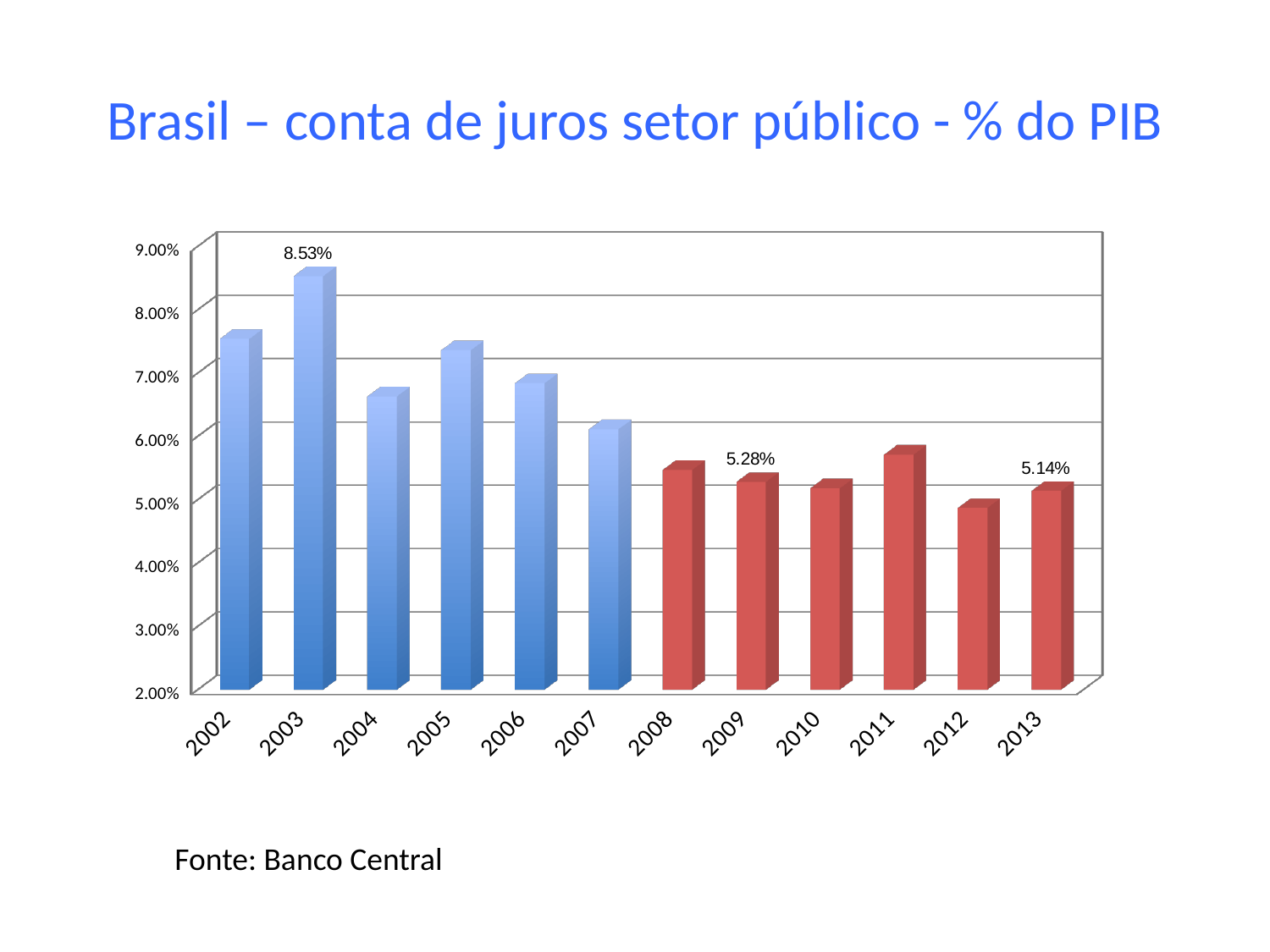
What is the value for 2013? 5.14% Which year has the highest value? 2003 What is the value for 2003? 8.53% Which is larger, the value for 2009 or the value for 2013? 2009 Is the value for 2012 greater or less than 5.00%? less What is the value for 2009? 5.28% Which year has the lowest value? 2012 What is the difference between the values for 2003 and 2009? 3.25 percentage points Do the values generally rise or fall from 2003 to 2013? fall What kind of chart is shown on the slide? bar chart How many years are shown on the x axis? 12 Is the value for 2002 greater or less than 7.00%? greater